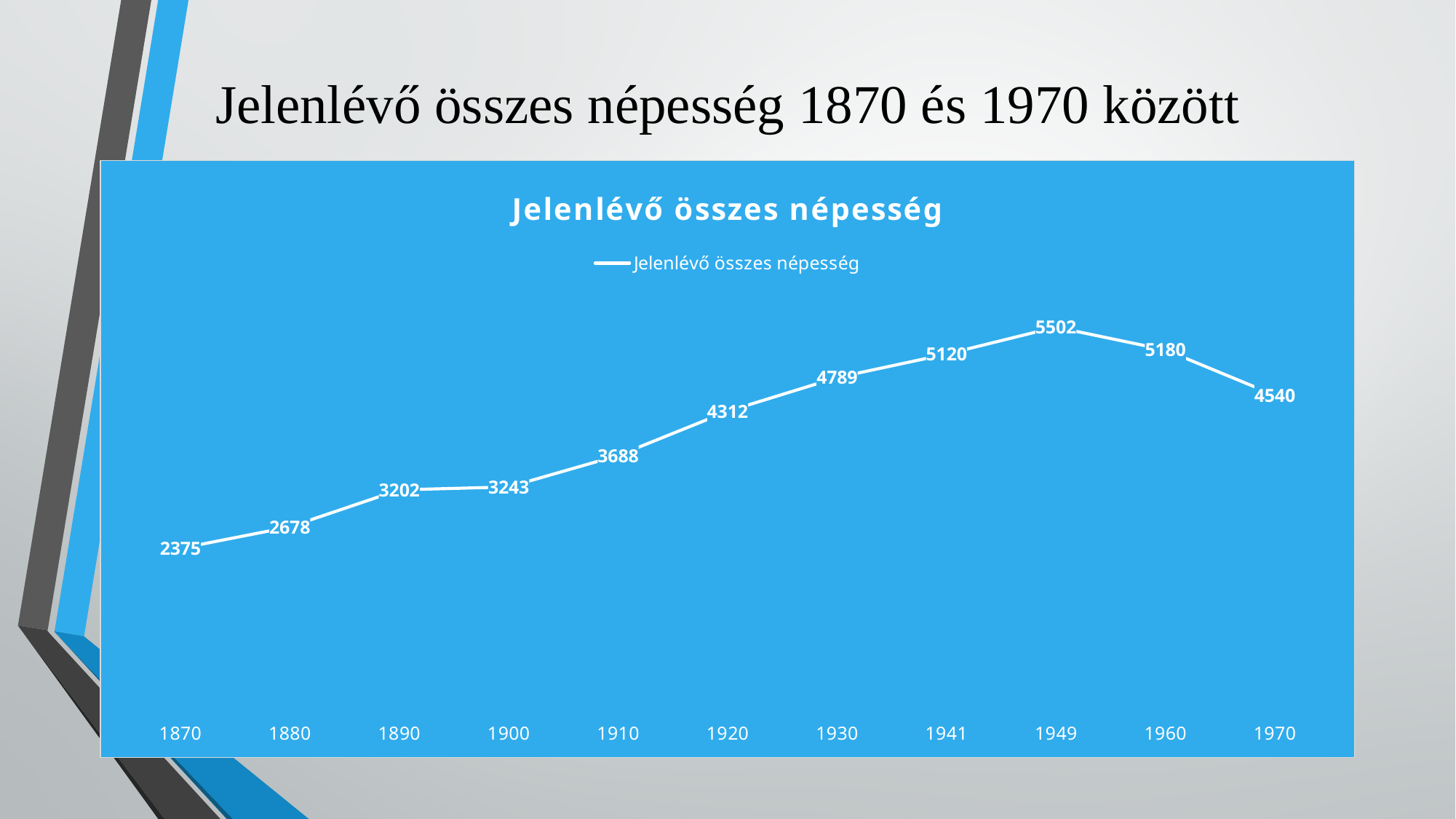
Which is larger, the value for 1960 or the value for 1941? 1960 What is the value for 1970? 4540 How many data points are plotted on the chart? 11 What is the difference between the values for 1880 and 1870? 303 What is the value for 1870? 2375 What is the title of the chart? Jelenlévő összes népesség Which year has the lowest value? 1870 What kind of chart is shown? line chart What is the difference between the values for 1949 and 1970? 962 What is the value for 1910? 3688 What is the value for 1949? 5502 Which year has the highest value? 1949